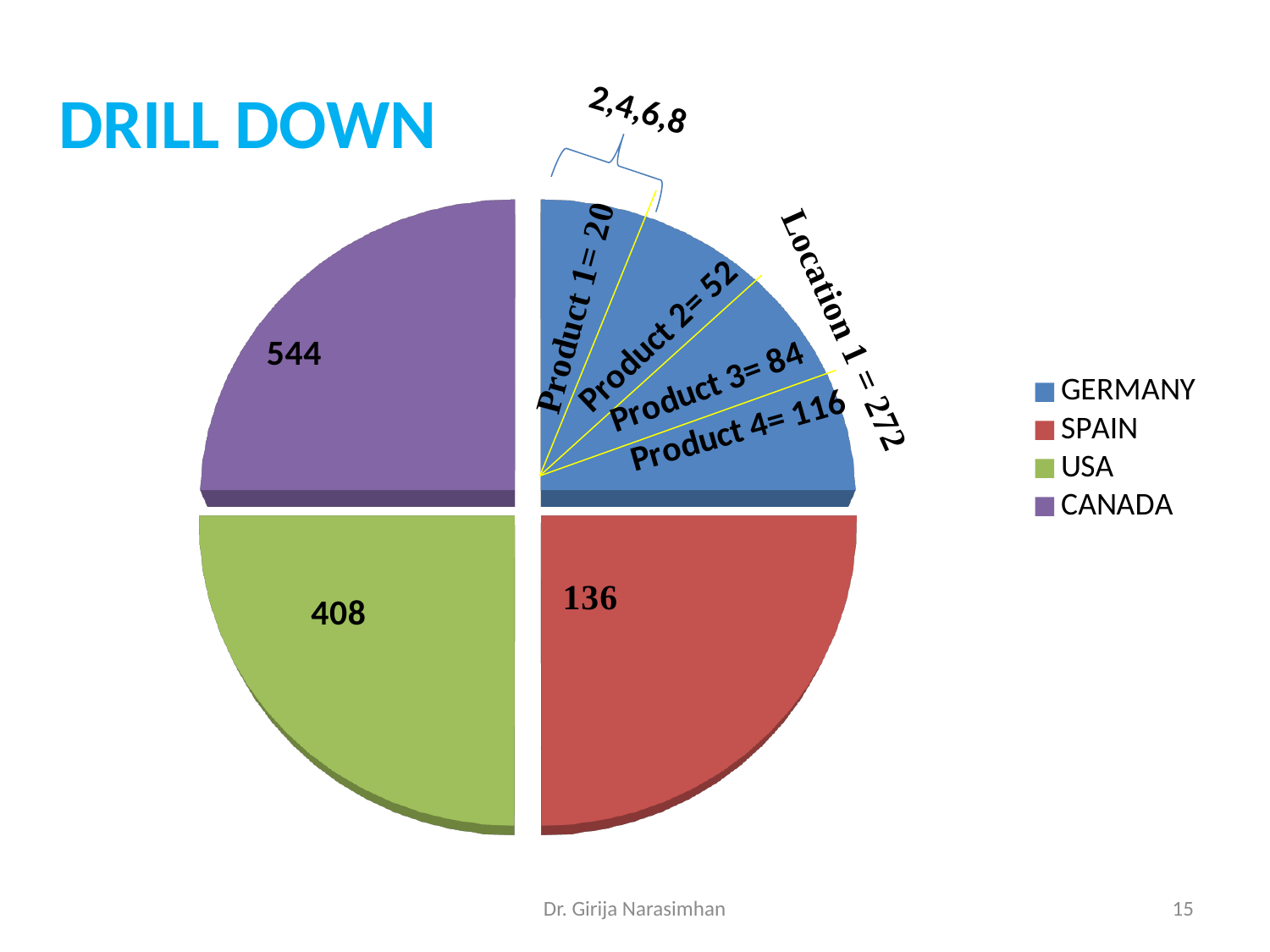
How many entries does the legend list? 4 What is the value shown for SPAIN? 136 What is the value shown for CANADA? 544 What value is shown for Product 3 within the GERMANY slice? 84 What kind of chart is shown on the slide? pie chart What is the value shown for USA? 408 What is the title of the slide? DRILL DOWN What value is shown for Product 4 within the GERMANY slice? 116 What is the difference between the values for CANADA and USA? 136 Which is larger, the value for USA or the value for SPAIN? USA